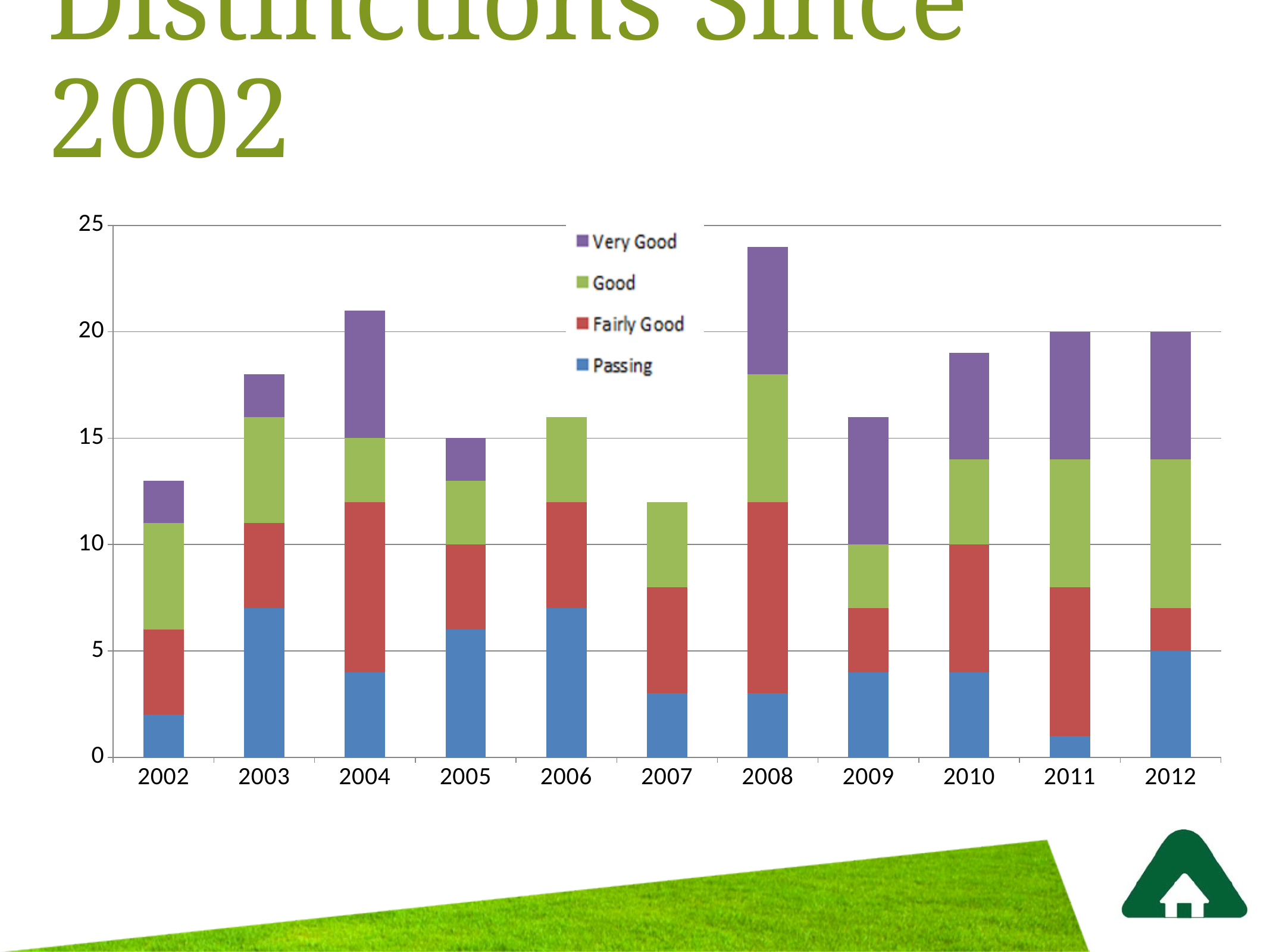
What kind of chart is shown on the slide? Stacked bar chart How many series does the legend list? 4 What is the total height of the stacked bar for 2005? 15 Is the total for 2007 greater or less than 15? less Is the total for 2008 greater or less than 20? greater What is the total height of the stacked bar for 2011? 20 How many years are shown along the x axis? 11 Which series is shown in blue in the legend? Passing Is the total for 2002 greater or less than 15? less Which year has the larger total, 2004 or 2005? 2004 What is the Passing value for 2012? 5 Which year has the tallest stacked bar? 2008